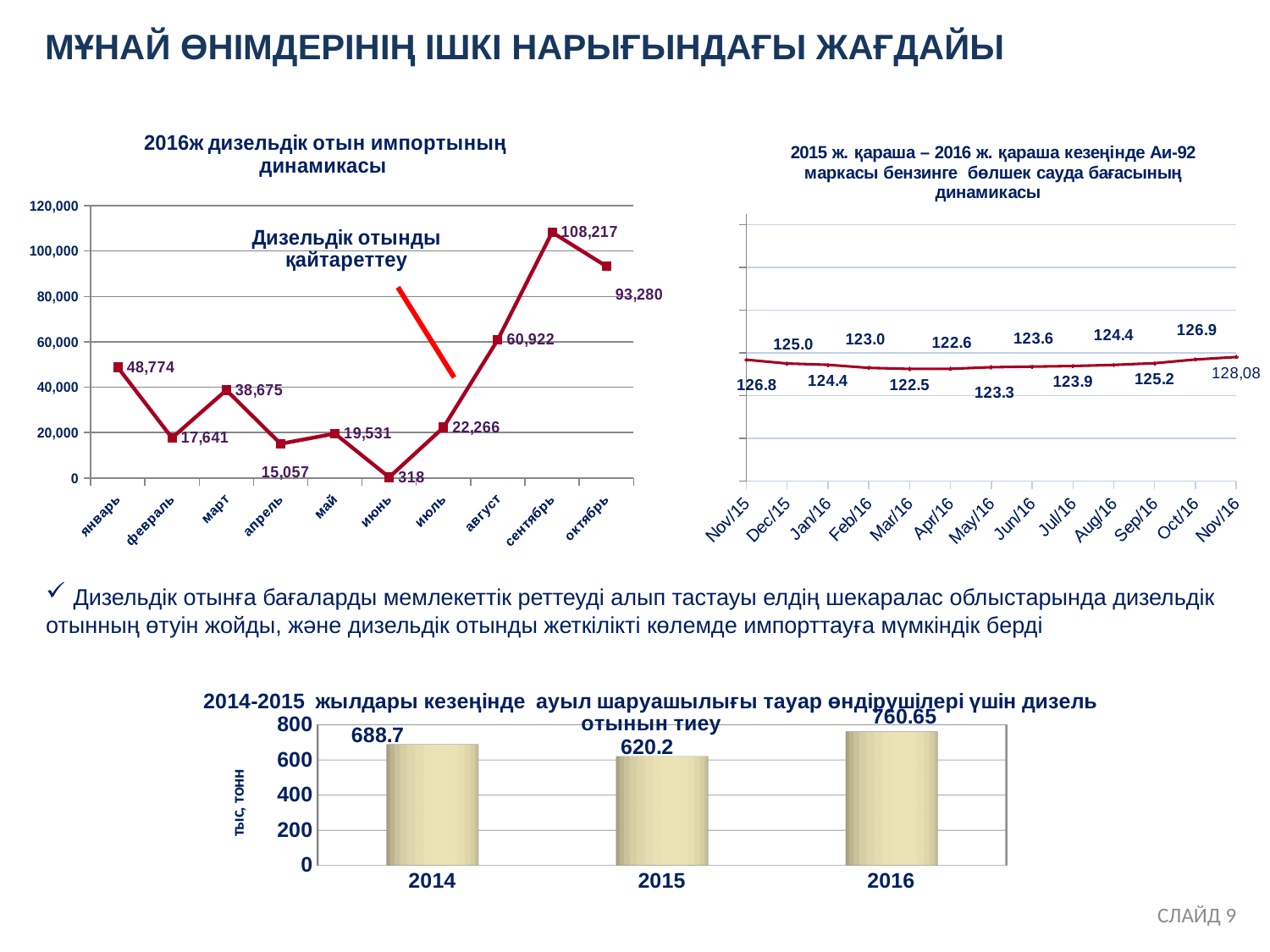
In the top-right chart on the Аи-92 petrol retail price, which month has the highest value? Nov/16 In the chart '2016ж дизельдік отын импортының динамикасы', which month has the lowest value? июнь In the top-right chart on the Аи-92 petrol retail price, what is the value for Mar/16? 122.5 In the bottom bar chart on diesel fuel shipments for agricultural producers, what is the value for 2016? 760.65 In the bottom bar chart on diesel fuel shipments for agricultural producers, what is the difference between the values for 2016 and 2015? 140.45 What kind of chart is the top-right chart on the Аи-92 petrol retail price? line chart In the chart '2016ж дизельдік отын импортының динамикасы', what is the value for сентябрь? 108,217 In the chart '2016ж дизельдік отын импортының динамикасы', what is the difference between the values for сентябрь and октябрь? 14,937 In the chart '2016ж дизельдік отын импортының динамикасы', which is larger, the value for январь or the value for март? январь In the top-right chart on the Аи-92 petrol retail price, how many data points are plotted? 13 In the chart '2016ж дизельдік отын импортының динамикасы', how many months are plotted on the x axis? 10 What is the y-axis label of the bottom bar chart on diesel fuel shipments for agricultural producers? тыс, тонн